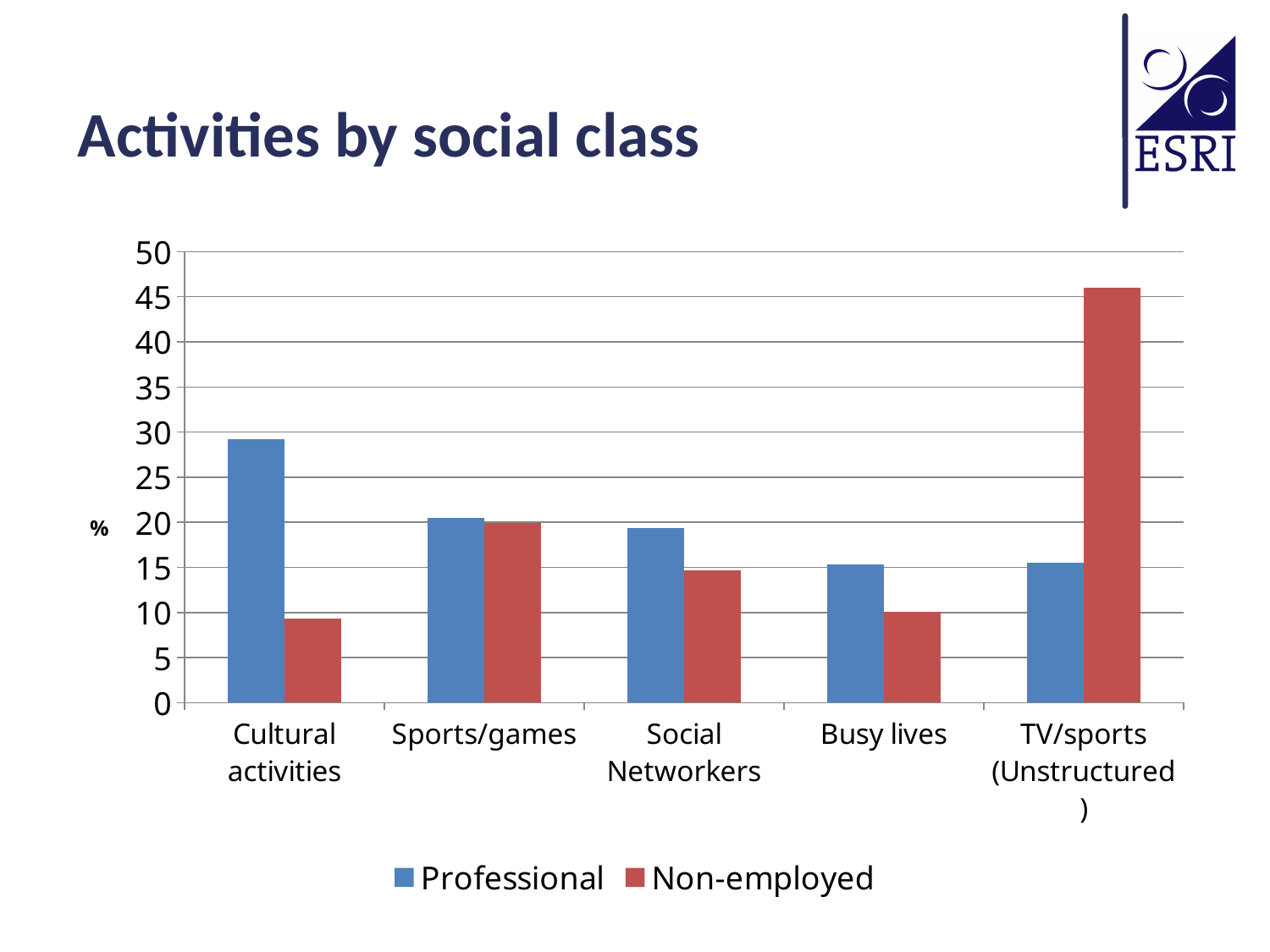
Is the Professional value for Cultural activities greater or less than 25? greater For Social Networkers, which series has the larger value, Professional or Non-employed? Professional How many activity categories are shown on the x axis? 5 Is the Non-employed value for TV/sports (Unstructured) greater or less than 40? greater Is the Professional value for TV/sports (Unstructured) greater or less than 20? less Which category has the highest value for the Non-employed series? TV/sports (Unstructured) How many series does the legend list? 2 What kind of chart is shown on the slide? bar chart What is the title of the chart on the slide? Activities by social class Which category has the highest value for the Professional series? Cultural activities For Cultural activities, which series has the larger value, Professional or Non-employed? Professional